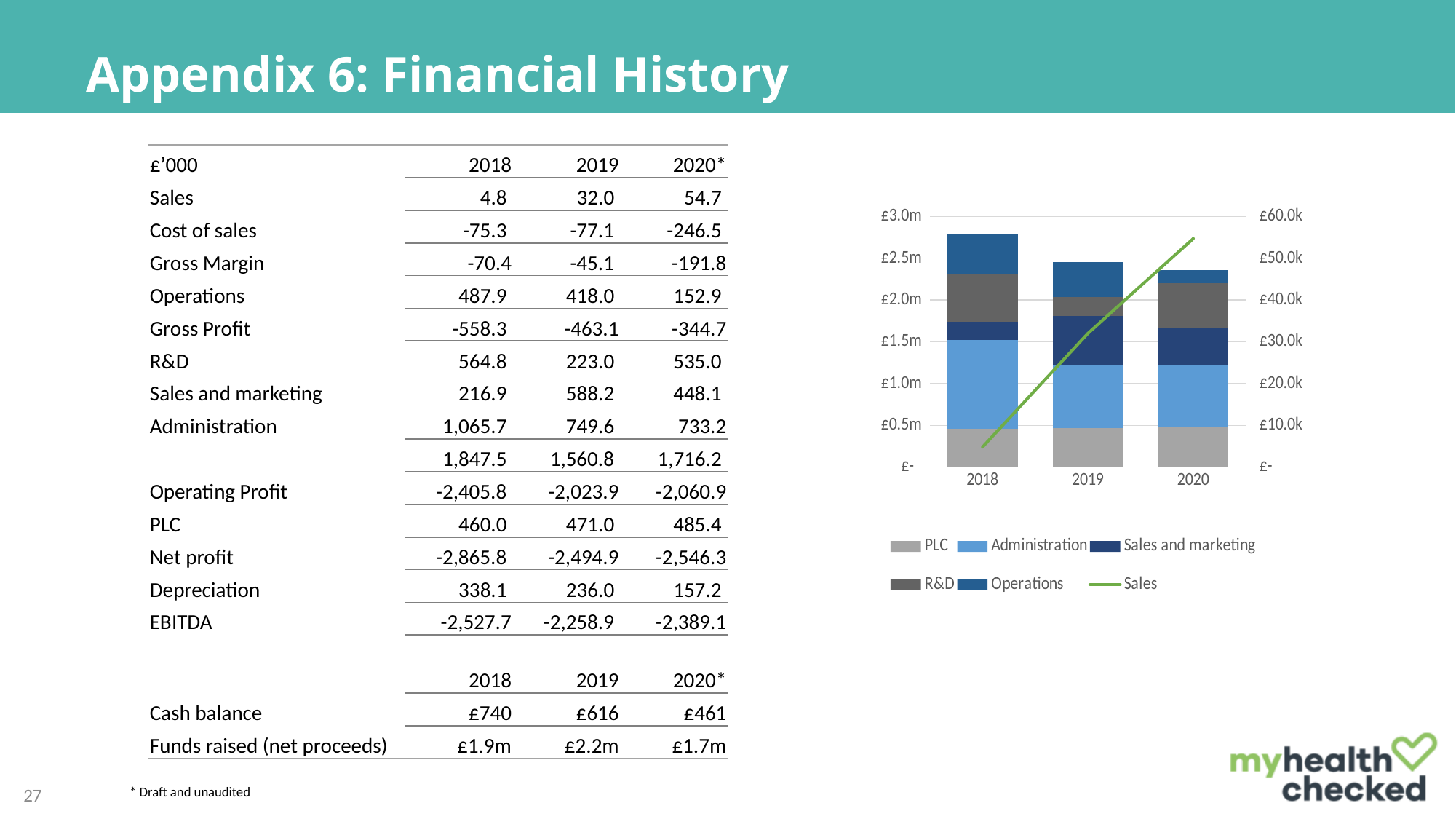
Is the Sales line value for 2020 greater or less than £50.0k? greater Is the total stacked bar for 2020 greater or less than £2.5m? less Is the Sales line value for 2018 greater or less than £10.0k? less What kind of chart is shown on the right of the slide? Stacked bar chart with a line Does the Sales line rise or fall from 2018 to 2020? Rises How many series does the chart's legend list? 6 Which series is plotted as a green line in the chart? Sales Which year has the tallest stacked bar? 2018 How many years are shown on the x axis of the chart? 3 Which stacked bar is taller, 2018 or 2020? 2018 In which year is the Sales line at its highest point? 2020